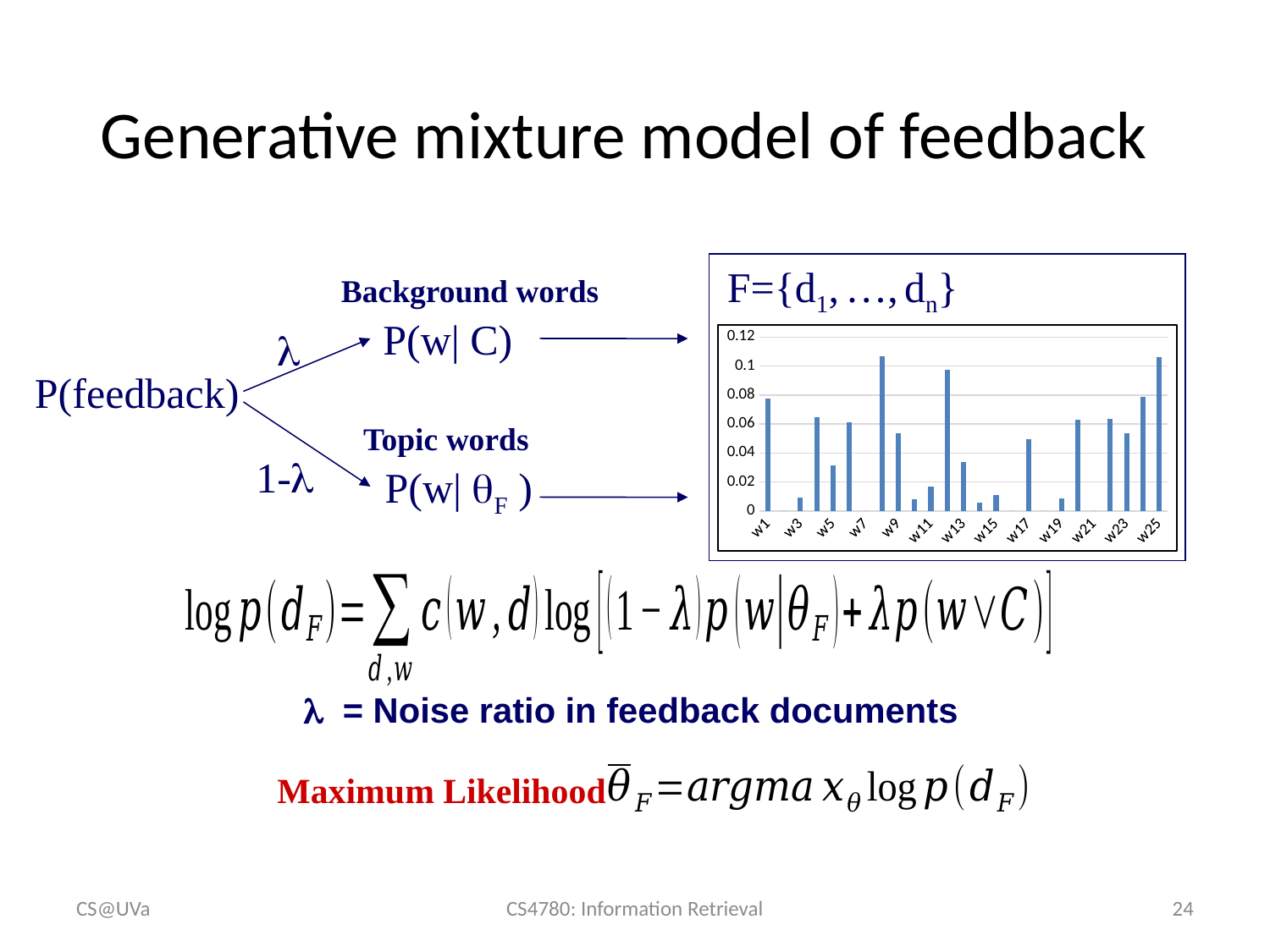
Is the value for w17 greater or less than 0.04? greater What is the highest value shown on the chart's vertical axis? 0.12 Is the value for w19 greater or less than 0.02? less Is the value for w3 greater or less than 0.02? less Which has the larger value, w1 or w5? w1 Which has the larger value, w13 or w25? w25 What kind of chart is shown on the slide? bar chart